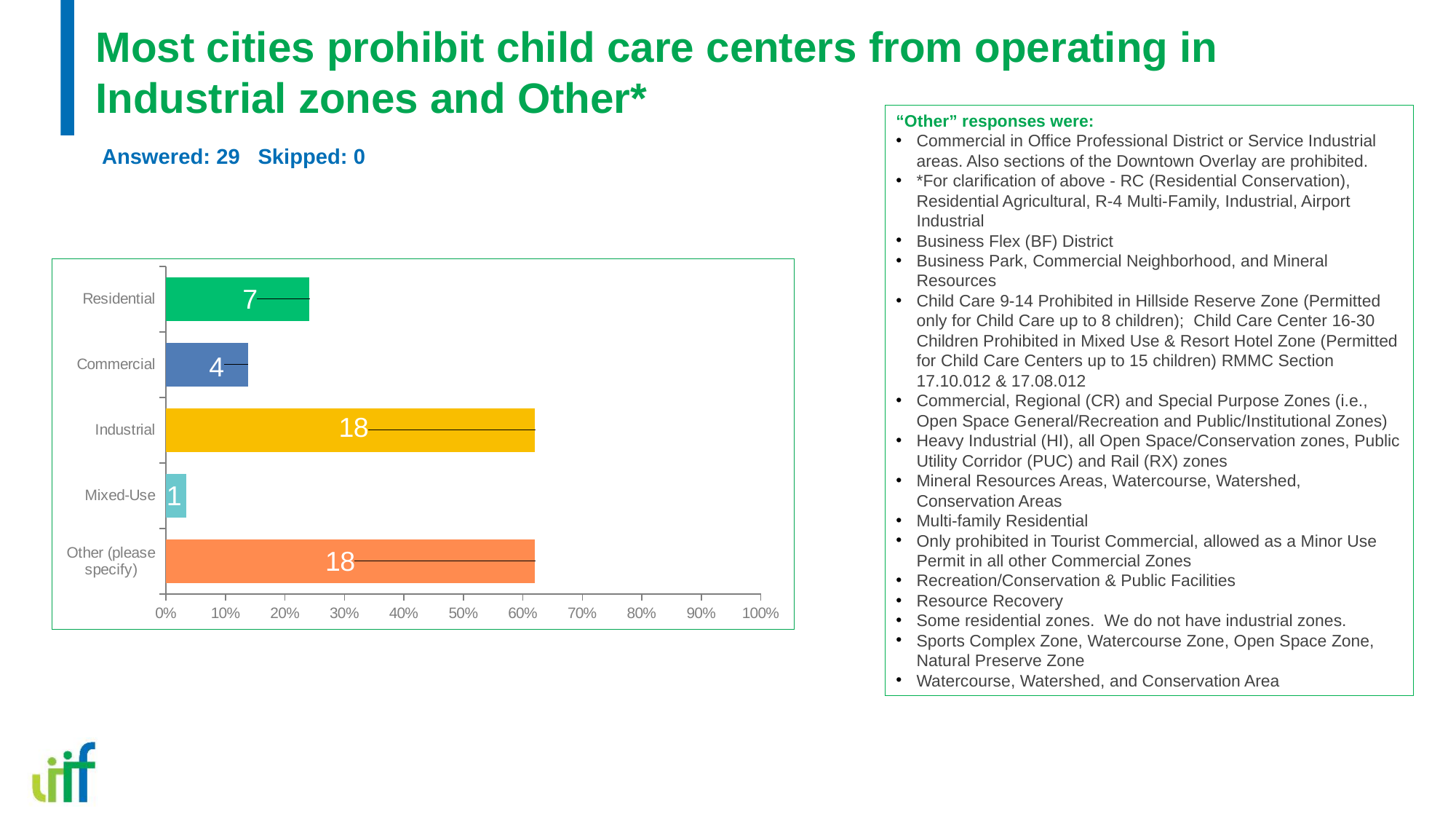
What is the data label for the Residential bar? 7 Is the Industrial bar greater or less than 50% on the x axis? greater What is the data label for the Other (please specify) bar? 18 Which category has the lowest value? Mixed-Use What is the data label for the Commercial bar? 4 Is the Residential bar greater or less than 30% on the x axis? less What is the data label for the Industrial bar? 18 What is the difference between the Residential and Commercial values? 3 How many categories are shown in the chart? 5 What kind of chart is shown on the slide? Bar chart Which is larger, the Residential value or the Commercial value? Residential What is the data label for the Mixed-Use bar? 1